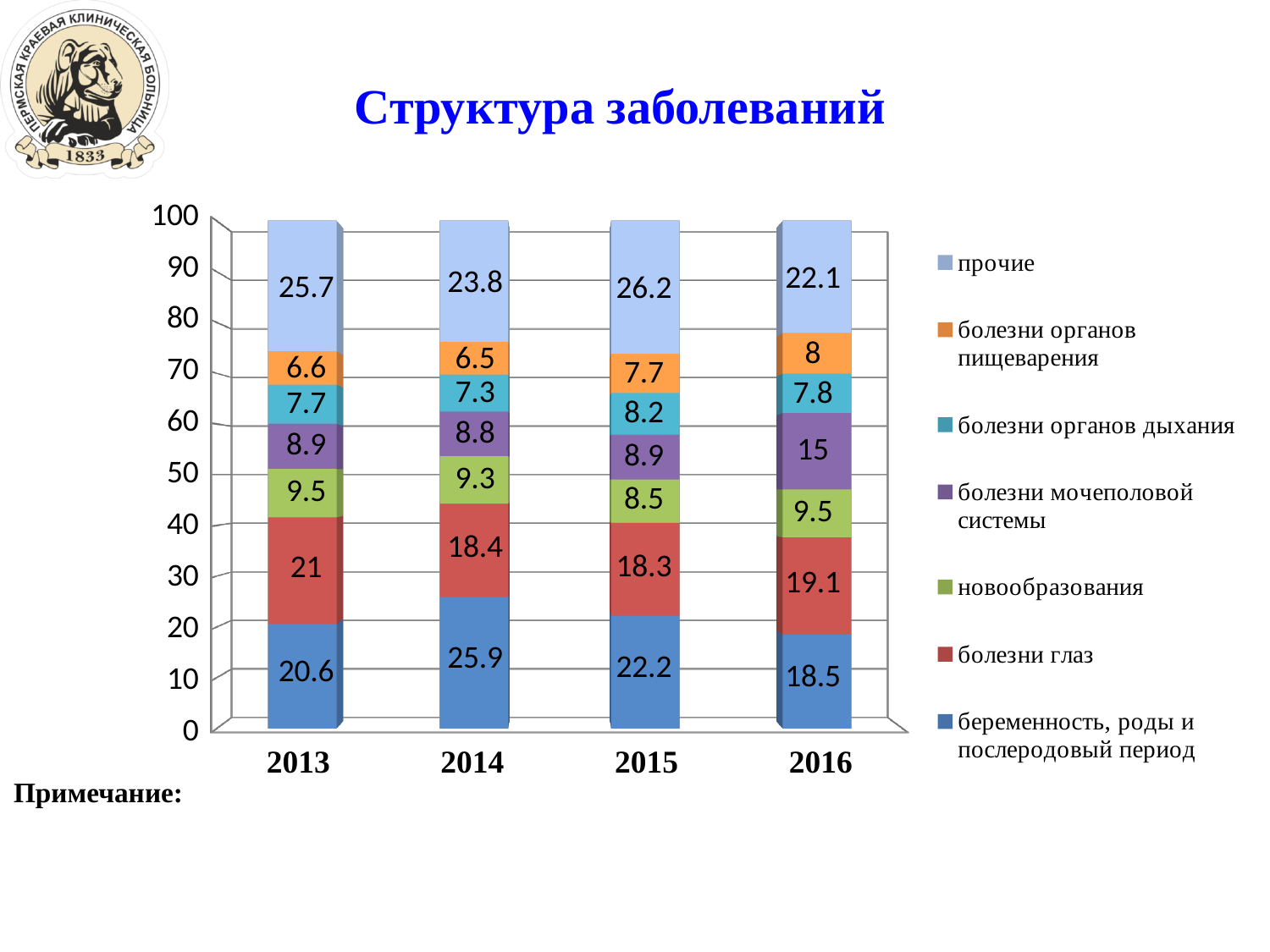
What is the value for 'болезни мочеполовой системы' in 2016? 15 In which year is the value for 'беременность, роды и послеродовый период' the lowest? 2016 What is the total of the stacked bar for 2016? 100 In which year is the value for 'болезни глаз' the highest? 2013 What is the value for 'прочие' in 2015? 26.2 Which is larger: 'новообразования' in 2014 or 'новообразования' in 2015? 2014 How many years (categories) are shown on the x axis? 4 What type of chart is shown on the slide? stacked bar chart Does the value for 'болезни органов пищеварения' rise or fall from 2013 to 2016? rise What is the value for 'беременность, роды и послеродовый период' in 2014? 25.9 How many series does the legend list? 7 What is the difference between the 'болезни глаз' values in 2013 and 2016? 1.9